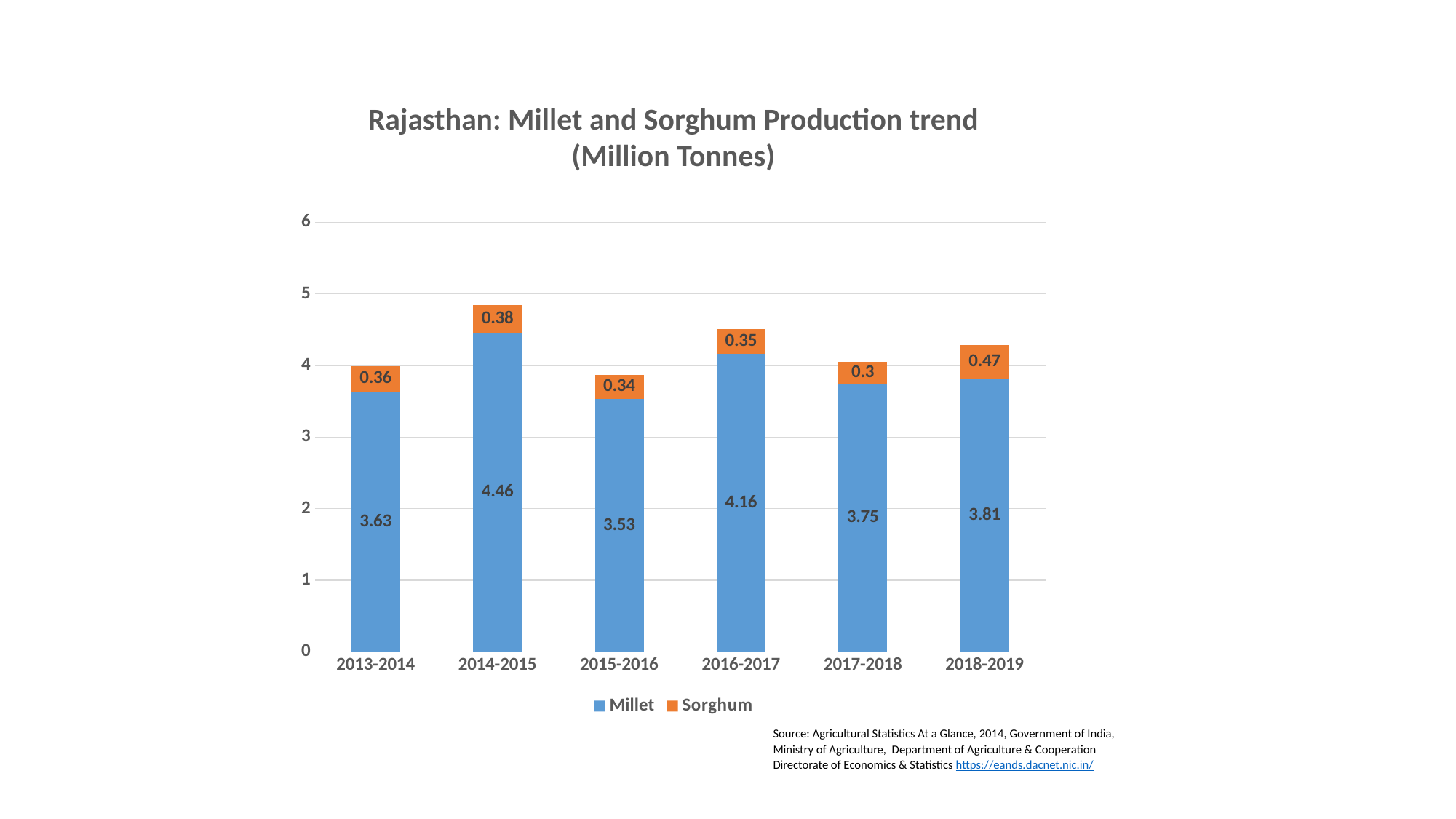
What is the Sorghum production value for 2018-2019? 0.47 What is the total of the stacked bar for 2013-2014? 3.99 How many series does the legend list? 2 Which year has the lowest Millet production? 2015-2016 What is the Millet production value for 2014-2015? 4.46 What is the difference between Millet production in 2014-2015 and 2015-2016? 0.93 How many years are shown on the x axis? 6 What is the Millet production value for 2017-2018? 3.75 Which year has the highest Millet production? 2014-2015 Is Millet production higher in 2016-2017 or in 2018-2019? 2016-2017 Which year has the lowest Sorghum production? 2017-2018 What kind of chart is shown on the slide? Stacked bar chart